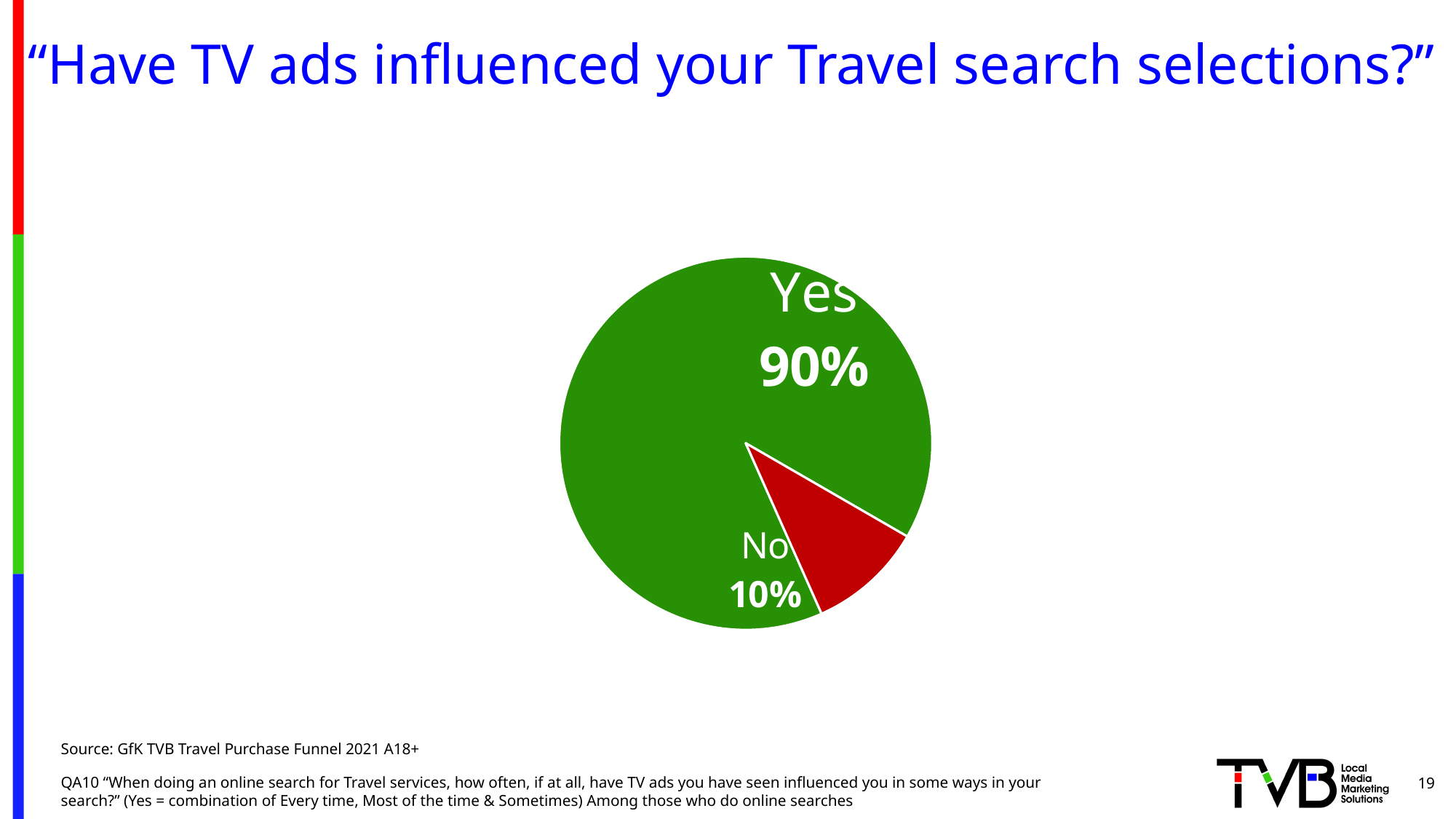
What percentage of respondents answered Yes? 90% What colour is the No slice? Red Which response has the largest share of the pie? Yes What share of the pie does the No slice represent? 10% Which is larger, the Yes share or the No share? Yes What is the difference in percentage points between the Yes and No shares? 80 What percentage of respondents answered No? 10% What kind of chart is shown on the slide? Pie chart What colour is the Yes slice? Green Which response has the smallest share of the pie? No How many slices does the pie chart have? 2